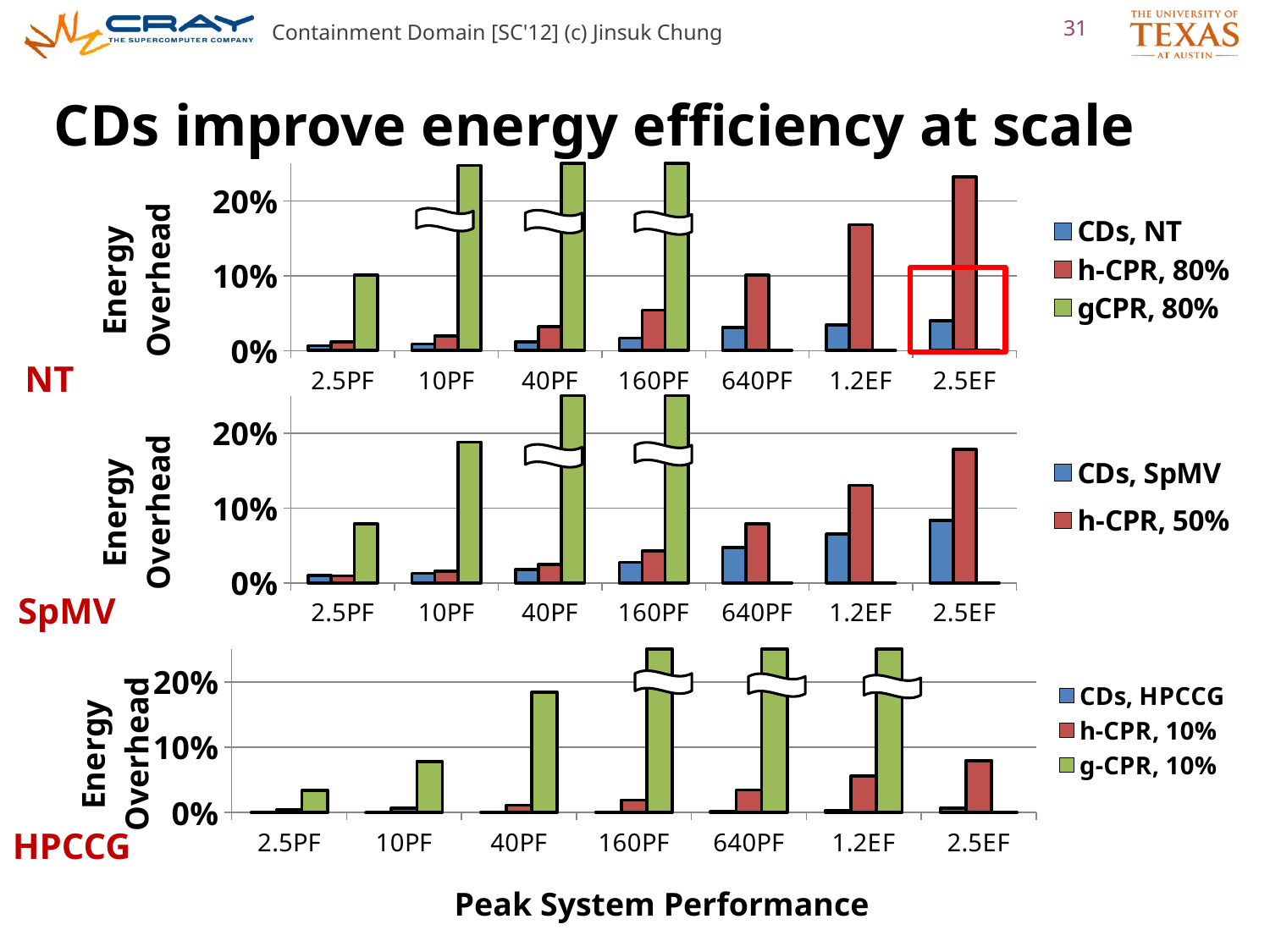
How many categories are shown on the x axis of the middle (SpMV) chart? 7 In the bottom (HPCCG) chart, is the value for h-CPR, 10% at 2.5EF greater or less than 10%? less How many series does the legend of the middle (SpMV) chart list? 2 What is the x axis label shared by the charts on the slide? Peak System Performance In the top (NT) chart, do the values for CDs, NT rise or fall as peak system performance increases along the x axis? rise In the top (NT) chart, is the value for h-CPR, 80% at 2.5EF greater or less than 20%? greater In the top (NT) chart, is the value for h-CPR, 80% at 1.2EF greater or less than 20%? less What kind of chart is the top (NT) chart on the slide? bar chart In the middle (SpMV) chart, which series has the highest value at 2.5EF? h-CPR, 50% How many series does the legend of the top (NT) chart list? 3 In the top (NT) chart, which is larger at 2.5EF: CDs, NT or h-CPR, 80%? h-CPR, 80%